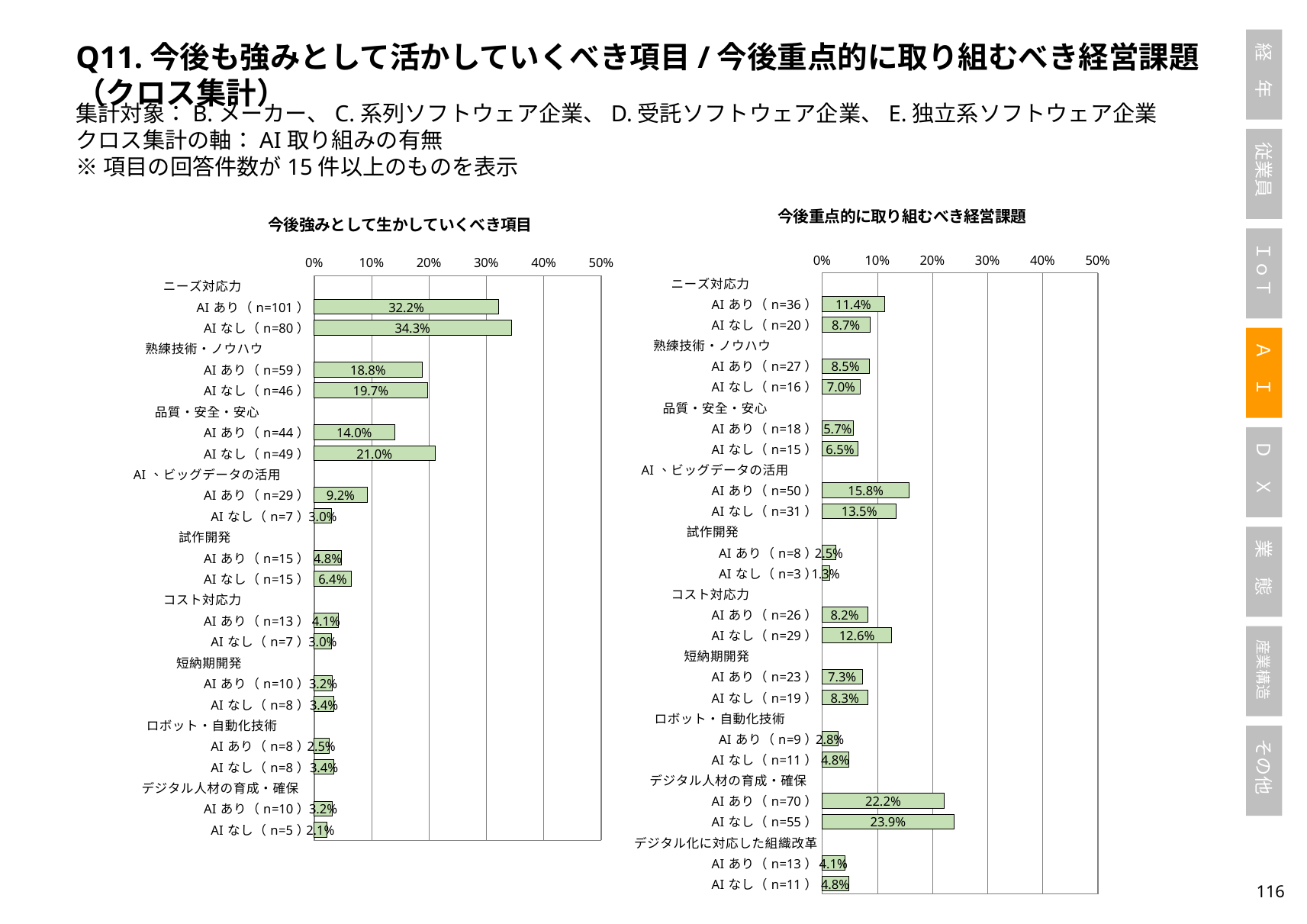
In the left chart (今後強みとして生かしていくべき項目), which bar has the highest value? ニーズ対応力 AIなし (n=80) In the left chart (今後強みとして生かしていくべき項目), what is the value for ニーズ対応力 AIあり (n=101)? 32.2% In the right chart (今後重点的に取り組むべき経営課題), what is the value for AI、ビッグデータの活用 AIあり (n=50)? 15.8% What type of chart is used on this slide? Bar chart In the right chart (今後重点的に取り組むべき経営課題), what is the difference between ニーズ対応力 AIあり (n=36) and AIなし (n=20)? 2.7% What is the title of the chart on the left side of the slide? 今後強みとして生かしていくべき項目 How many item categories (group headings) are shown in the left chart (今後強みとして生かしていくべき項目)? 9 In the right chart (今後重点的に取り組むべき経営課題), which bar has the lowest value? 試作開発 AIなし (n=3) In the left chart (今後強みとして生かしていくべき項目), what is the difference between 品質・安全・安心 AIなし (n=49) and AIあり (n=44)? 7.0% How many item categories (group headings) are shown in the right chart (今後重点的に取り組むべき経営課題)? 10 In the right chart (今後重点的に取り組むべき経営課題), which is larger for コスト対応力: AIあり (n=26) or AIなし (n=29)? AIなし (n=29) In the right chart (今後重点的に取り組むべき経営課題), is the value for デジタル人材の育成・確保 AIなし (n=55) greater or less than 20%? greater